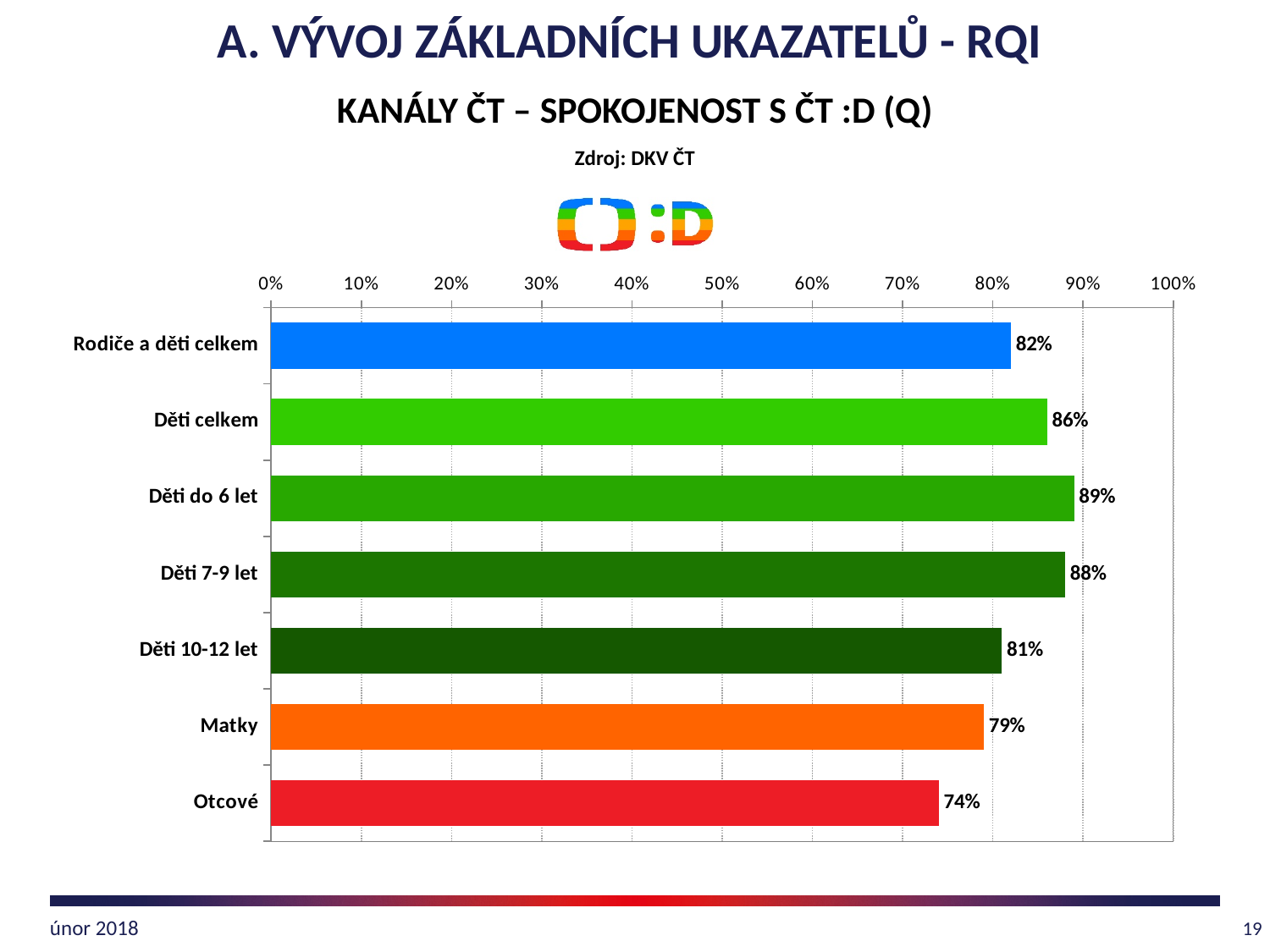
What is the difference between the values for Matky and Otcové? 5% What is the source given for the chart? DKV ČT What is the value for Rodiče a děti celkem? 82% What is the value for Matky? 79% What is the value for Otcové? 74% Which is larger, the value for Děti 7-9 let or the value for Děti 10-12 let? Děti 7-9 let How many categories are shown in the chart? 7 Which category has the lowest value? Otcové What kind of chart is shown on the slide? bar chart Which category has the highest value? Děti do 6 let What is the value for Děti do 6 let? 89% What is the difference between the values for Děti celkem and Děti 10-12 let? 5%